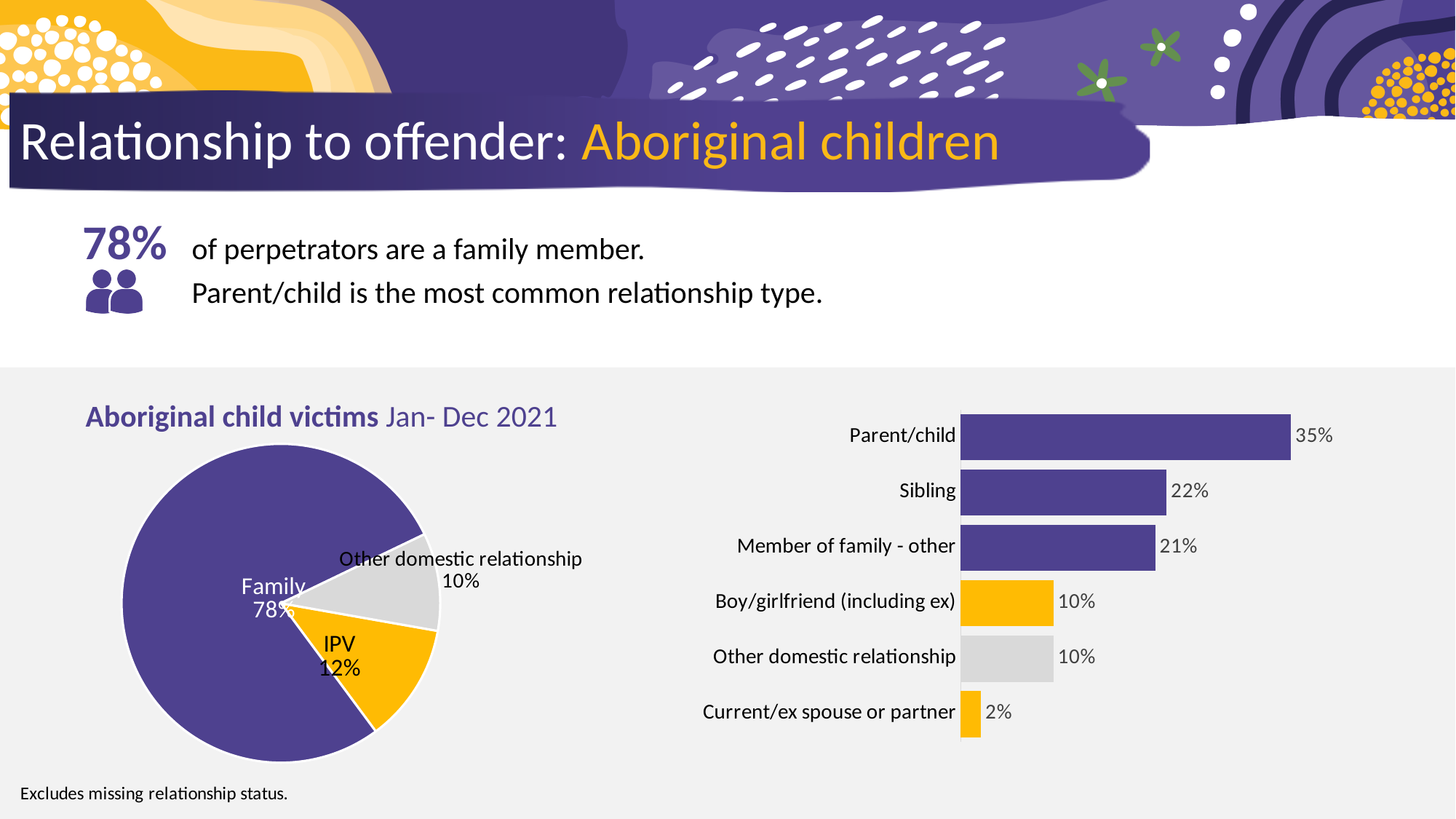
In the pie chart on the left, what share of the pie is the Family slice? 78% What kind of chart is shown on the right side of the slide? Bar chart In the bar chart on the right, which is larger, Sibling or Boy/girlfriend (including ex)? Sibling In the bar chart on the right, what is the value for Sibling? 22% In the bar chart on the right, what is the value for Parent/child? 35% In the bar chart on the right, how many categories are shown? 6 In the pie chart on the left, how many slices are there? 3 In the bar chart on the right, what is the difference between Parent/child and Member of family - other? 14% In the pie chart on the left, what is the value for Other domestic relationship? 10% In the bar chart on the right, which category has the lowest value? Current/ex spouse or partner In the pie chart on the left, what is the value for IPV? 12% In the pie chart on the left, which slice is the largest? Family